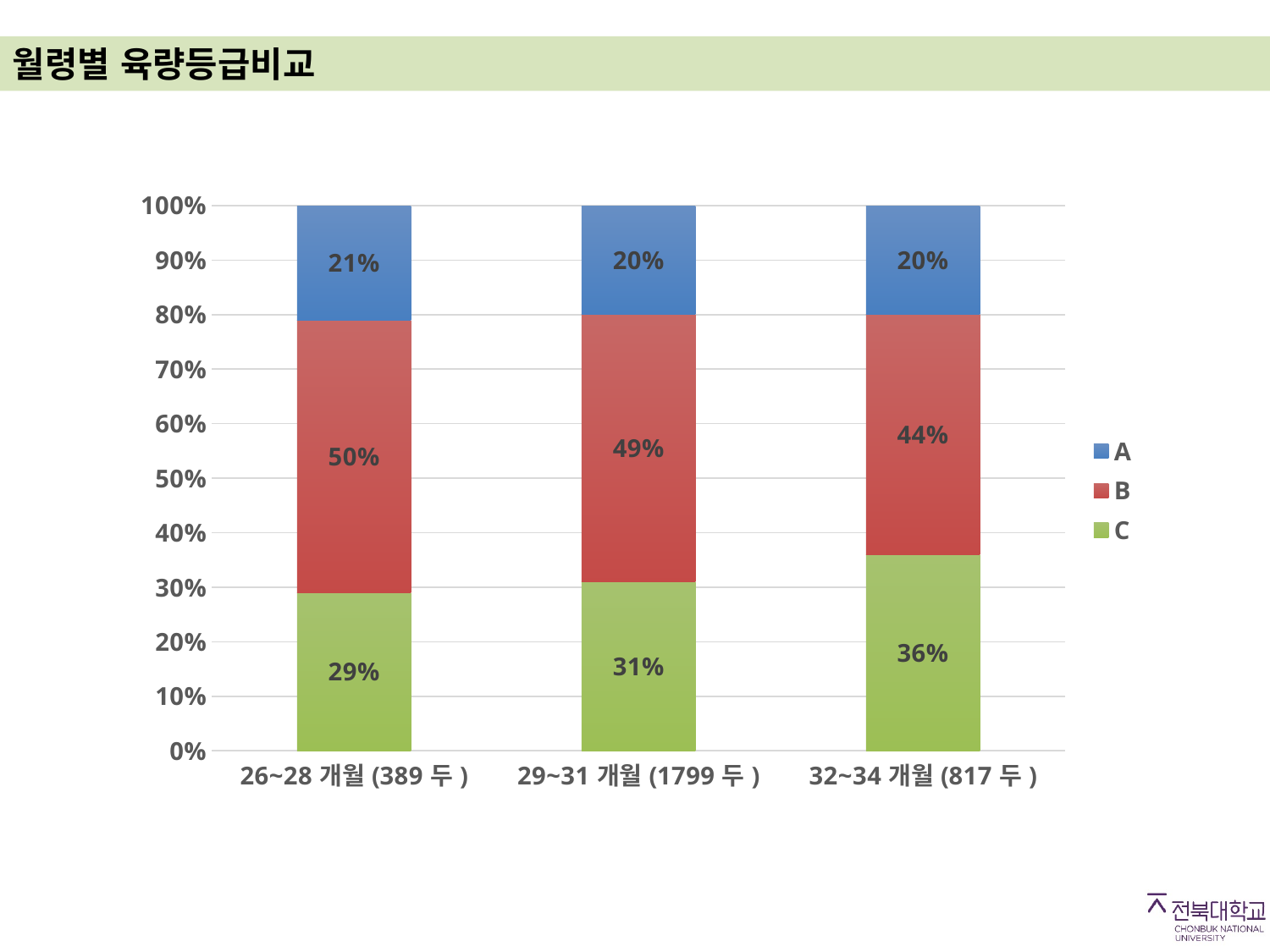
What is the value for series C in the 32~34 개월 (817 두) category? 36% What is the value for series B in the 26~28 개월 (389 두) category? 50% What is the difference between the series B values for 26~28 개월 (389 두) and 32~34 개월 (817 두)? 6% What is the value for series A in the 29~31 개월 (1799 두) category? 20% Which is larger: series C for 29~31 개월 (1799 두) or series C for 26~28 개월 (389 두)? 29~31 개월 (1799 두) Do the values for series C rise or fall from left to right along the x axis? Rise What is the title of the slide? 월령별 육량등급비교 How many categories are shown on the x axis? 3 How many series does the legend list? 3 Which category has the lowest value for series B? 32~34 개월 (817 두) Which category has the highest value for series C? 32~34 개월 (817 두) What kind of chart is shown on the slide? Stacked bar chart